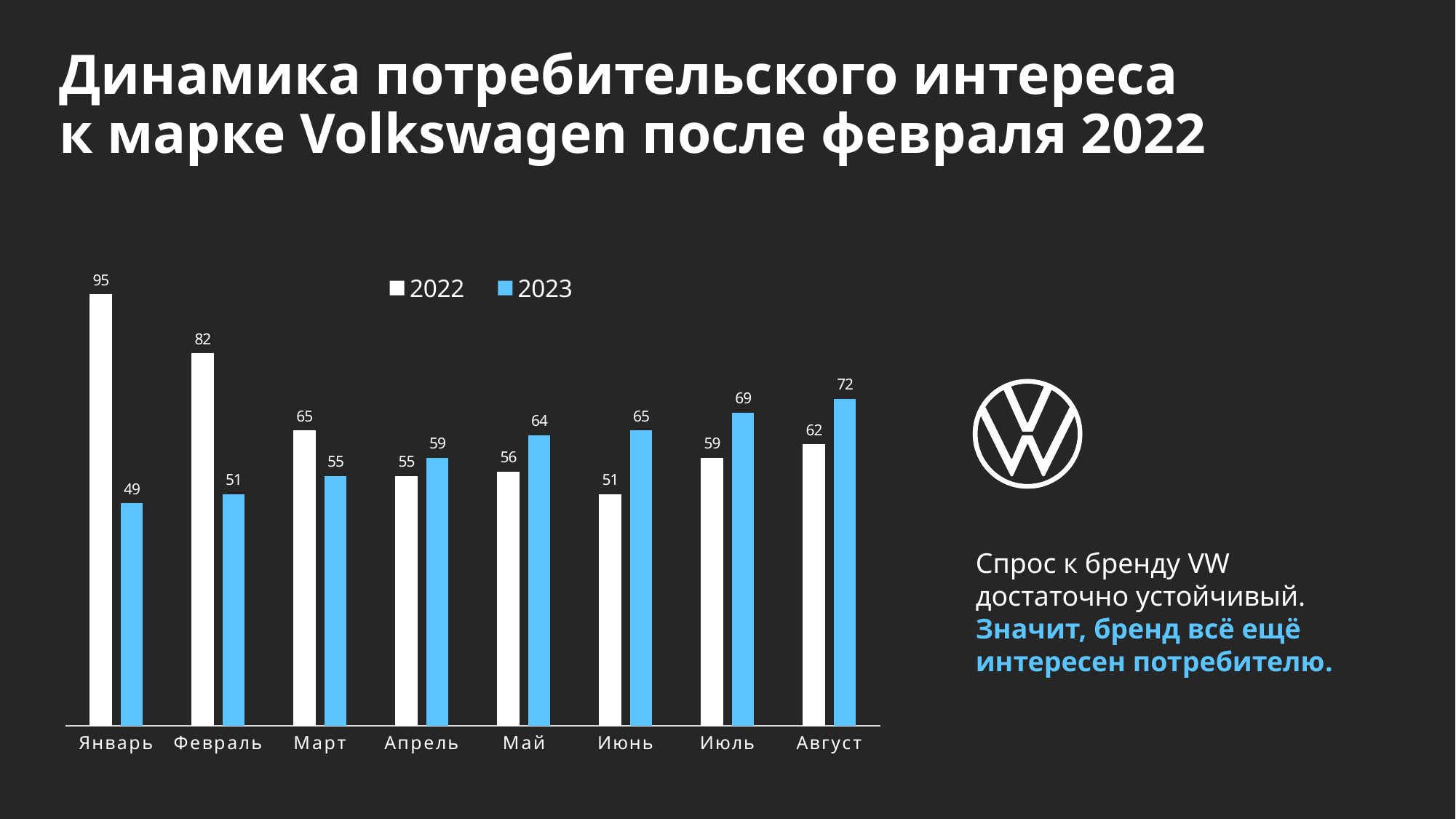
What colour are the bars for the 2023 series? Blue Which month has the lowest value for the 2023 series? Январь Which is larger in Июль: the 2022 value or the 2023 value? 2023 Which month has the highest value for the 2022 series? Январь What kind of chart is shown on the slide? Bar chart What is the value for 2022 in Январь? 95 What is the value for 2023 in Август? 72 How many series does the legend list? 2 How many months are shown on the x axis? 8 Do the 2023 values generally rise or fall from Январь to Август? Rise What is the value for 2023 in Май? 64 What is the difference between the 2022 and 2023 values in Февраль? 31